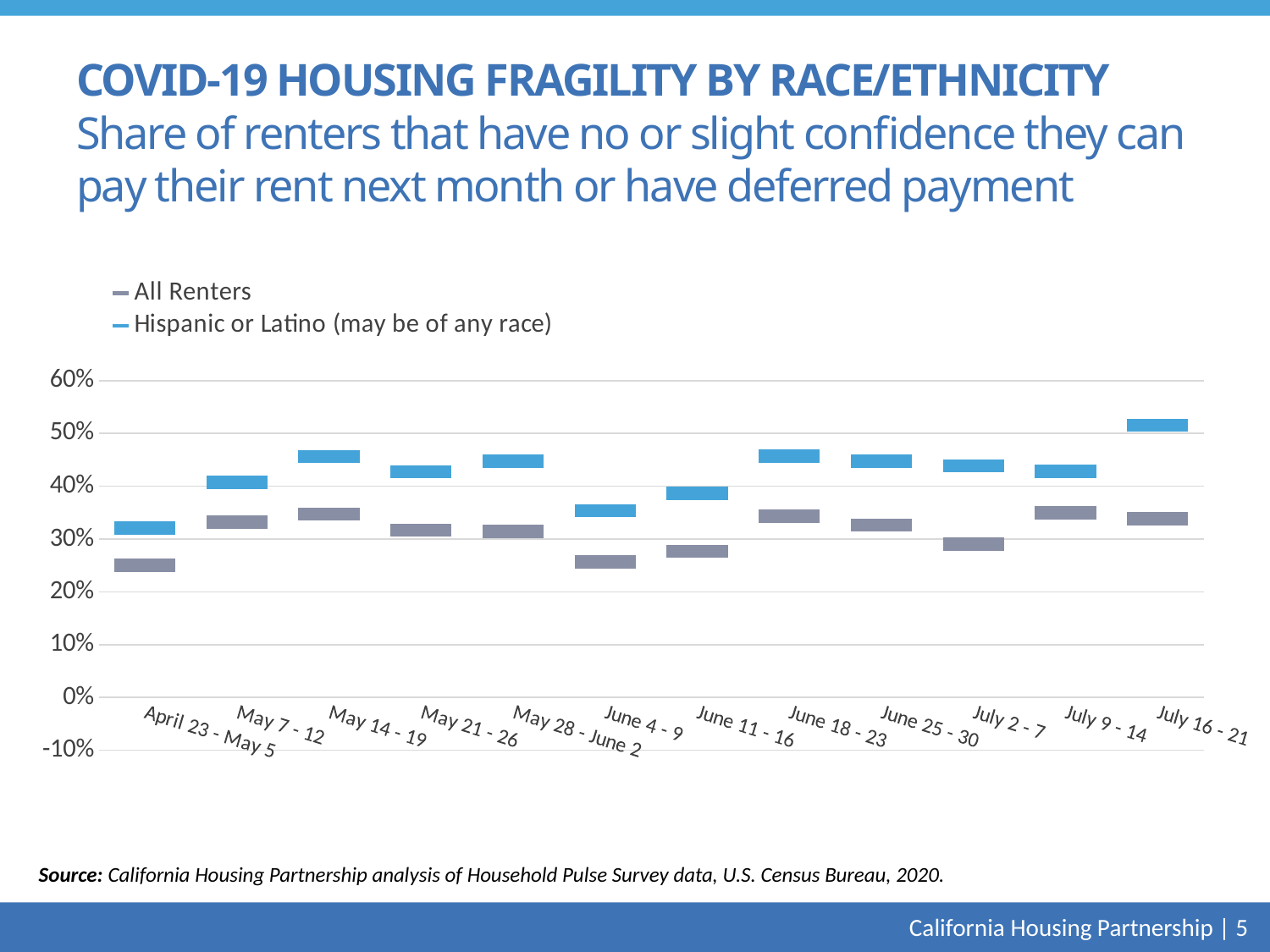
Is the Hispanic or Latino value for July 16 - 21 greater or less than 50%? greater For which time period is the Hispanic or Latino value lowest? April 23 - May 5 Is the All Renters value for April 23 - May 5 greater or less than 30%? less Which series is shown in blue in the chart? Hispanic or Latino (may be of any race) What are the two series named in the chart legend? All Renters; Hispanic or Latino (may be of any race) Is the All Renters value for June 4 - 9 greater or less than 30%? less Does the Hispanic or Latino value rise or fall from May 28 - June 2 to June 4 - 9? fall For which time period is the Hispanic or Latino value highest? July 16 - 21 How many series does the chart legend list? 2 For June 18 - 23, which series has the larger value, All Renters or Hispanic or Latino? Hispanic or Latino How many time periods are shown on the x axis of the chart? 12